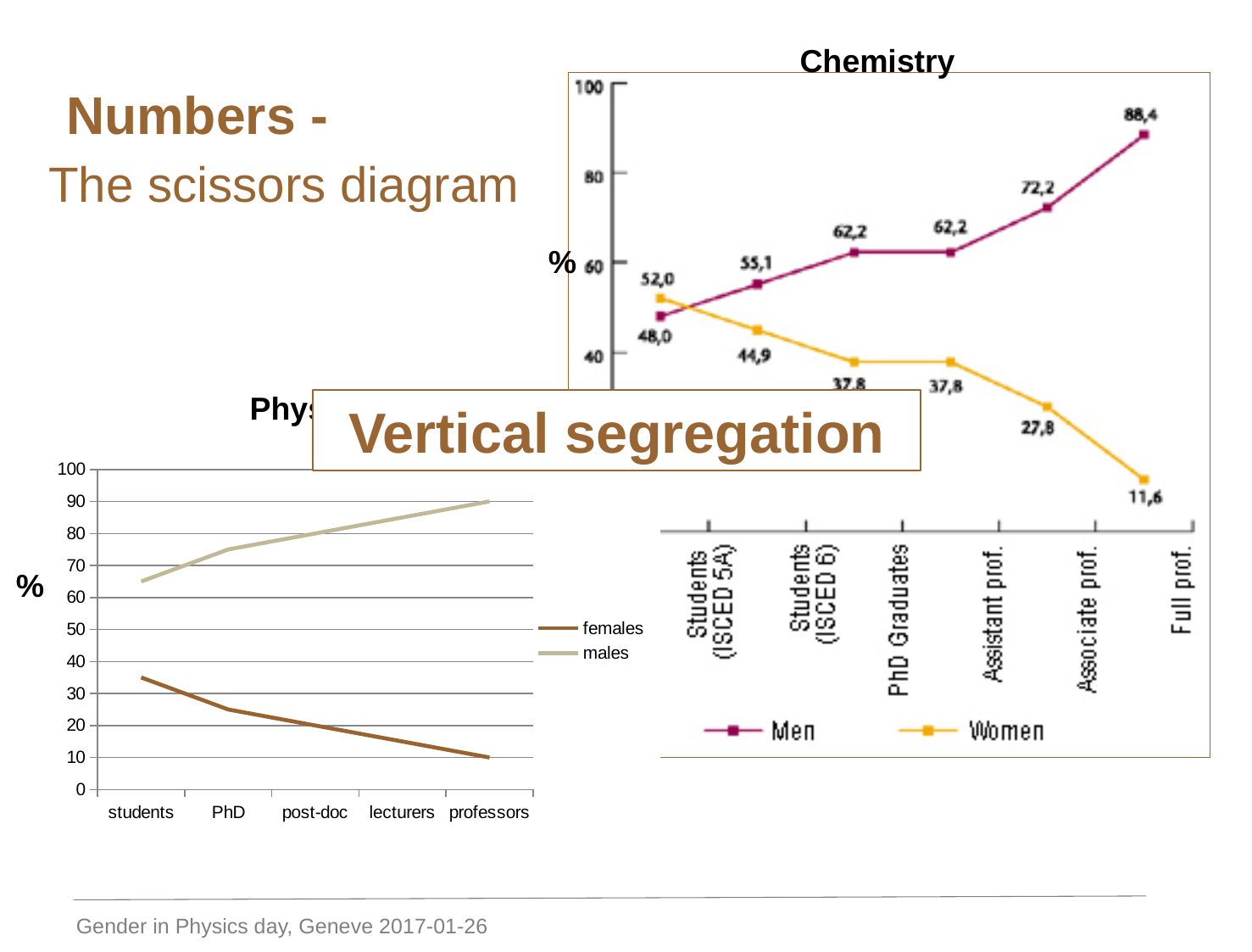
On the bottom-left chart, is the value for females at students greater or less than 30? greater On the Chemistry chart, what is the value for Women at Students (ISCED 5A)? 52,0 On the bottom-left chart, what is the value for males at professors? 90 On the Chemistry chart, what is the value for Men at Students (ISCED 5A)? 48,0 What kind of chart is the bottom-left chart? line chart On the Chemistry chart, which series has the larger value at Students (ISCED 6): Men or Women? Men On the Chemistry chart, what is the lowest value shown for Women? 11,6 On the Chemistry chart, does the Women line rise or fall from left to right? fall On the Chemistry chart, what is the difference between the Men and Women values at Associate prof. (72,2 and 27,8)? 44,4 On the Chemistry chart, what is the highest value shown for Men? 88,4 On the Chemistry chart, how many series does the legend list? 2 On the bottom-left chart, how many categories are on the x axis? 5